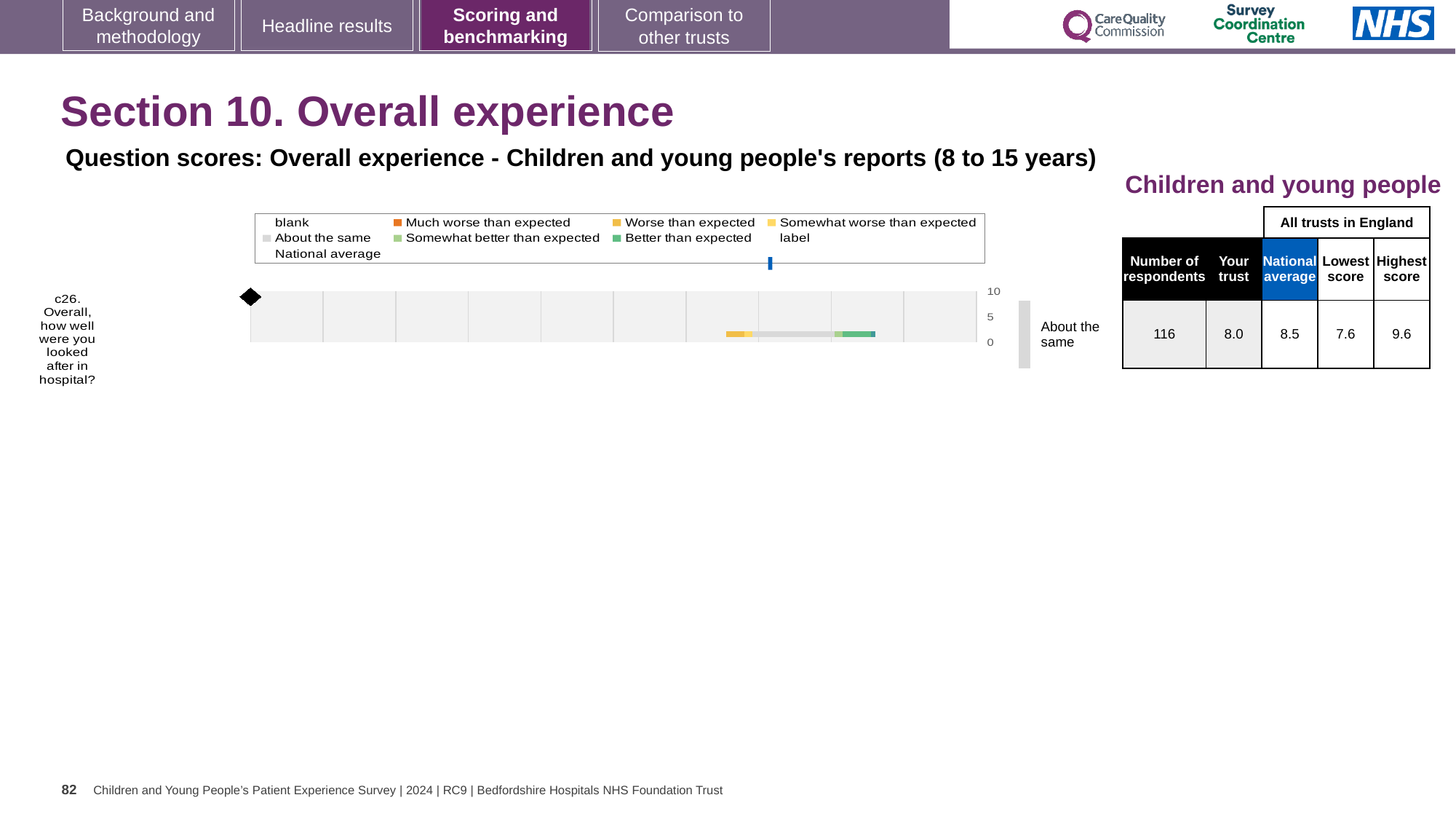
What is the difference between the highest score and the lowest score for question c26? 2.0 What is the highest score among all trusts in England for question c26? 9.6 What is the national average score for question c26? 8.5 What kind of chart is used to show the question score for c26? Bar chart Which is larger for question c26: the 'Your trust' score or the national average? National average What is the difference between the national average and the 'Your trust' score for question c26? 0.5 What is the lowest score among all trusts in England for question c26? 7.6 How many survey questions are plotted in the chart? 1 What is the 'Your trust' score for question c26 'Overall, how well were you looked after in hospital?'? 8.0 How many respondents answered question c26? 116 What is the title of the chart? Question scores: Overall experience - Children and young people's reports (8 to 15 years) What benchmark category is shown next to the bar for question c26? About the same